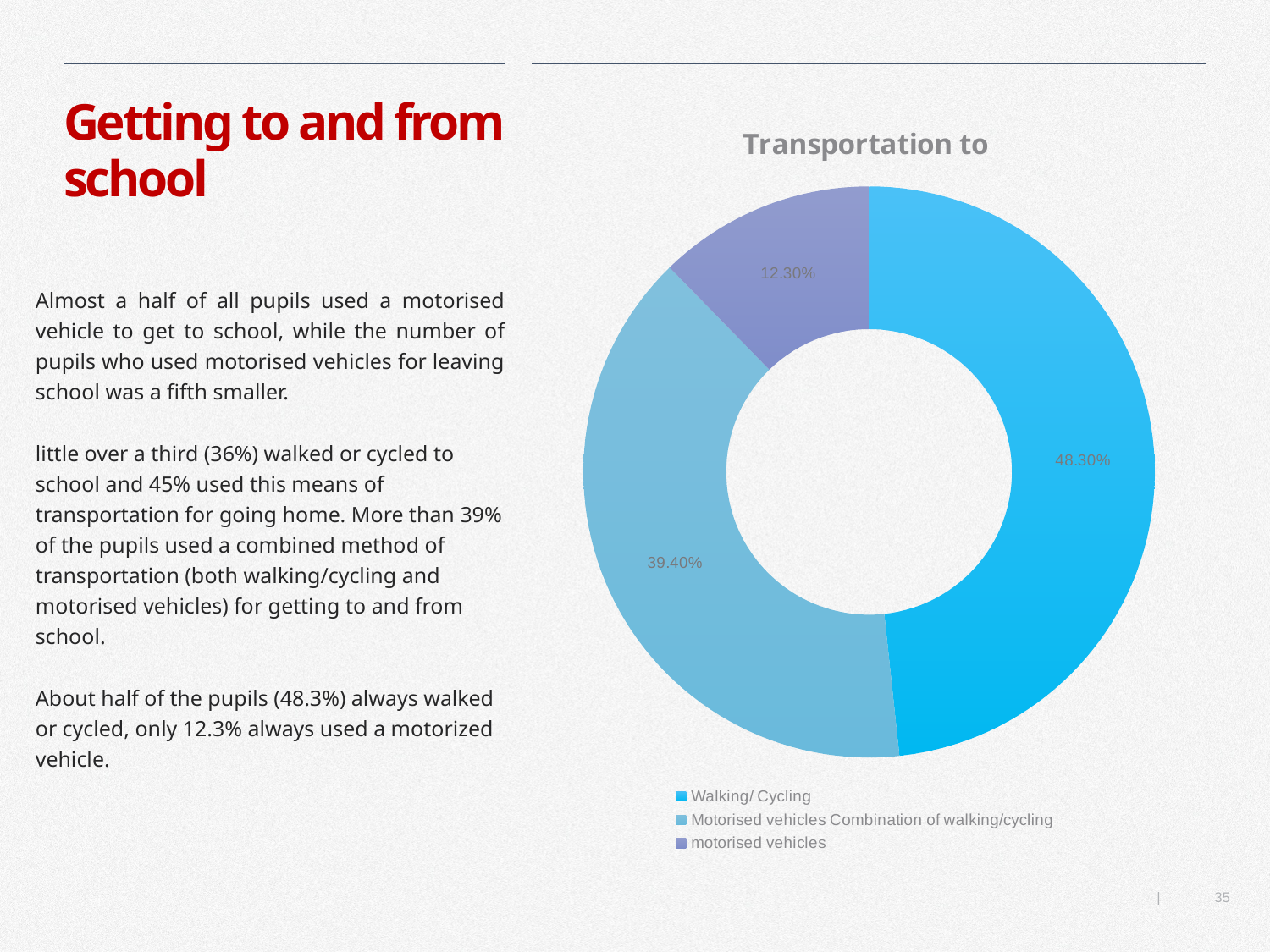
What is the difference in percentage points between the Walking/ Cycling slice and the motorised vehicles slice? 36 percentage points What percentage is shown for the motorised vehicles slice? 12.30% How many entries does the legend list? 3 What kind of chart is shown on the slide? Doughnut (pie) chart Which category has the largest share of the chart? Walking/ Cycling Which category has the smallest share of the chart? motorised vehicles Which is larger: the Walking/ Cycling slice or the Motorised vehicles Combination of walking/cycling slice? Walking/ Cycling What percentage of the chart is labelled for Walking/ Cycling? 48.30% How many slices does the chart have? 3 What is the title of the chart? Transportation to What percentage is shown for the Motorised vehicles Combination of walking/cycling slice? 39.40% What colour is the motorised vehicles slice? Purple